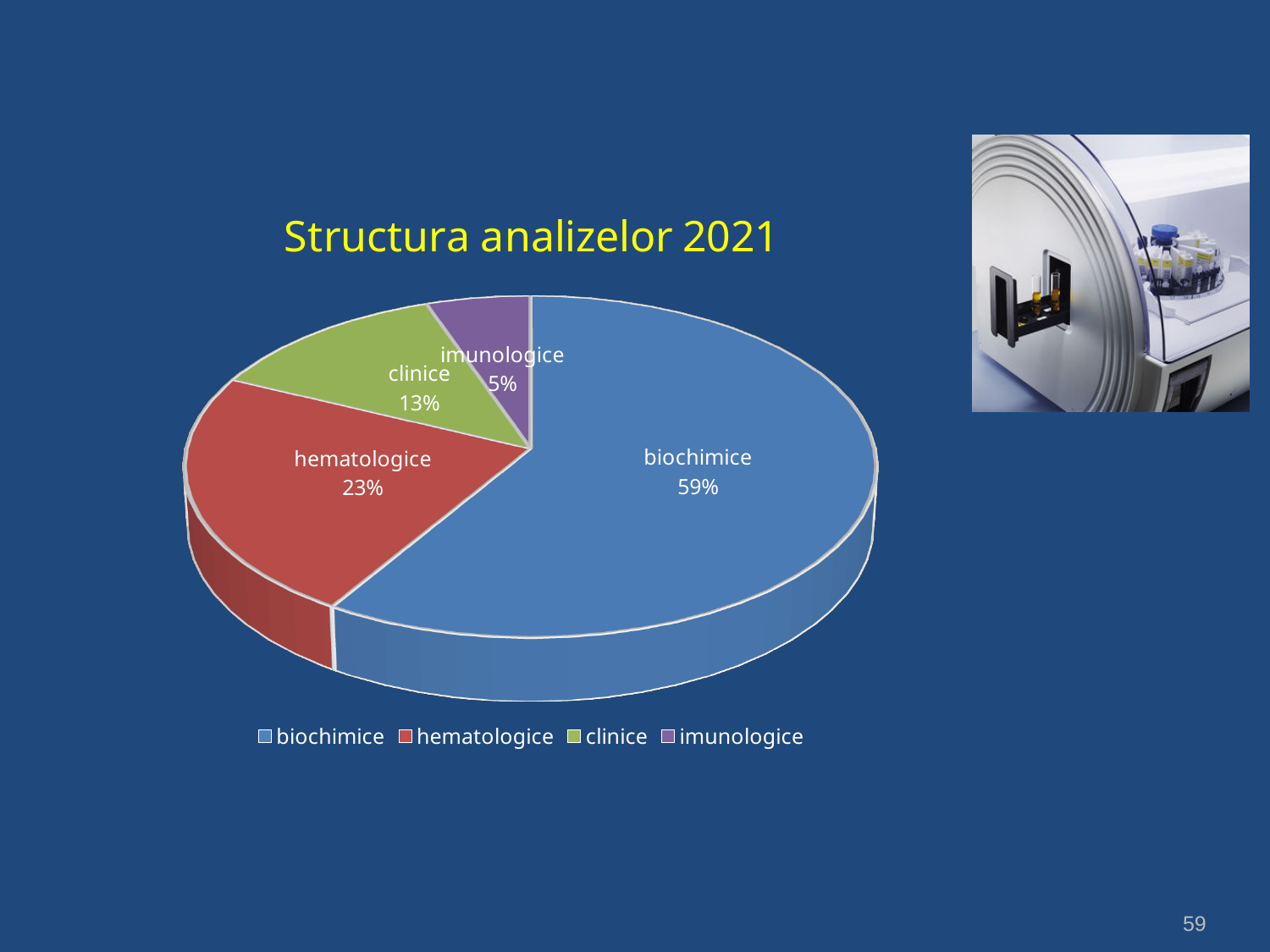
What kind of chart is shown on the slide? pie chart How many categories are shown in the pie chart? 4 Which category has the largest slice of the pie? biochimice What is the difference between the shares of biochimice and hematologice? 36% Which category has the smallest slice of the pie? imunologice What share of the pie does hematologice represent? 23% What share of the pie does biochimice represent? 59% What is the value shown for clinice? 13% Which is larger, the share for hematologice or the share for clinice? hematologice What is the difference between the shares of clinice and imunologice? 8% What is the title of the chart? Structura analizelor 2021 What is the value shown for imunologice? 5%